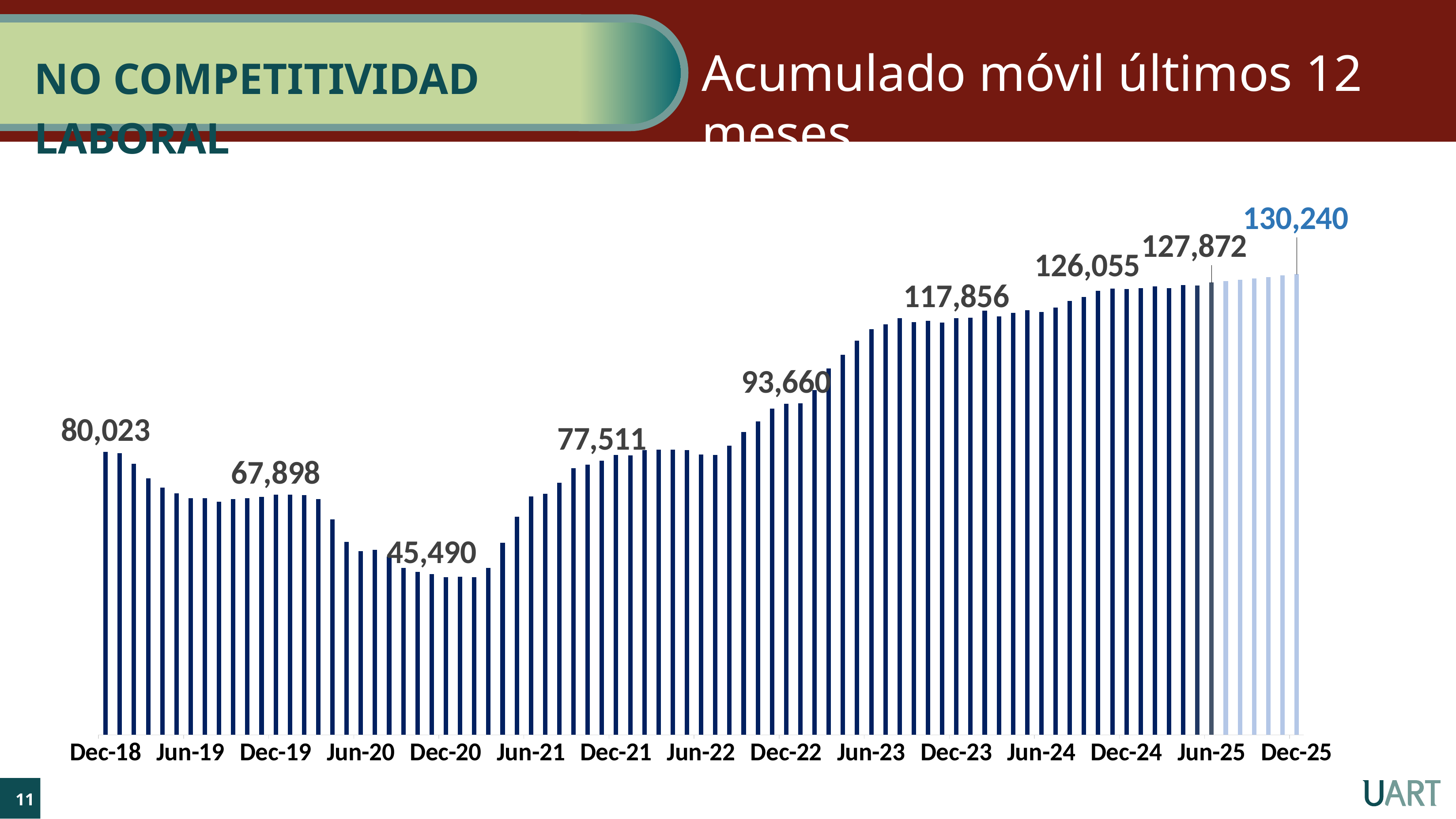
What is the difference between the values for Dec-25 and Dec-24? 4,185 Which labeled period has the highest value on the chart? Dec-25 Which is larger, the value for Dec-19 or the value for Dec-21? Dec-21 What is the value shown for Dec-18? 80,023 What is the value shown for Dec-25? 130,240 What kind of chart is shown on the slide? Bar chart What is the value shown for Jun-25? 127,872 Do the values rise or fall from Dec-20 to Dec-25? Rise What is the value shown for Dec-23? 117,856